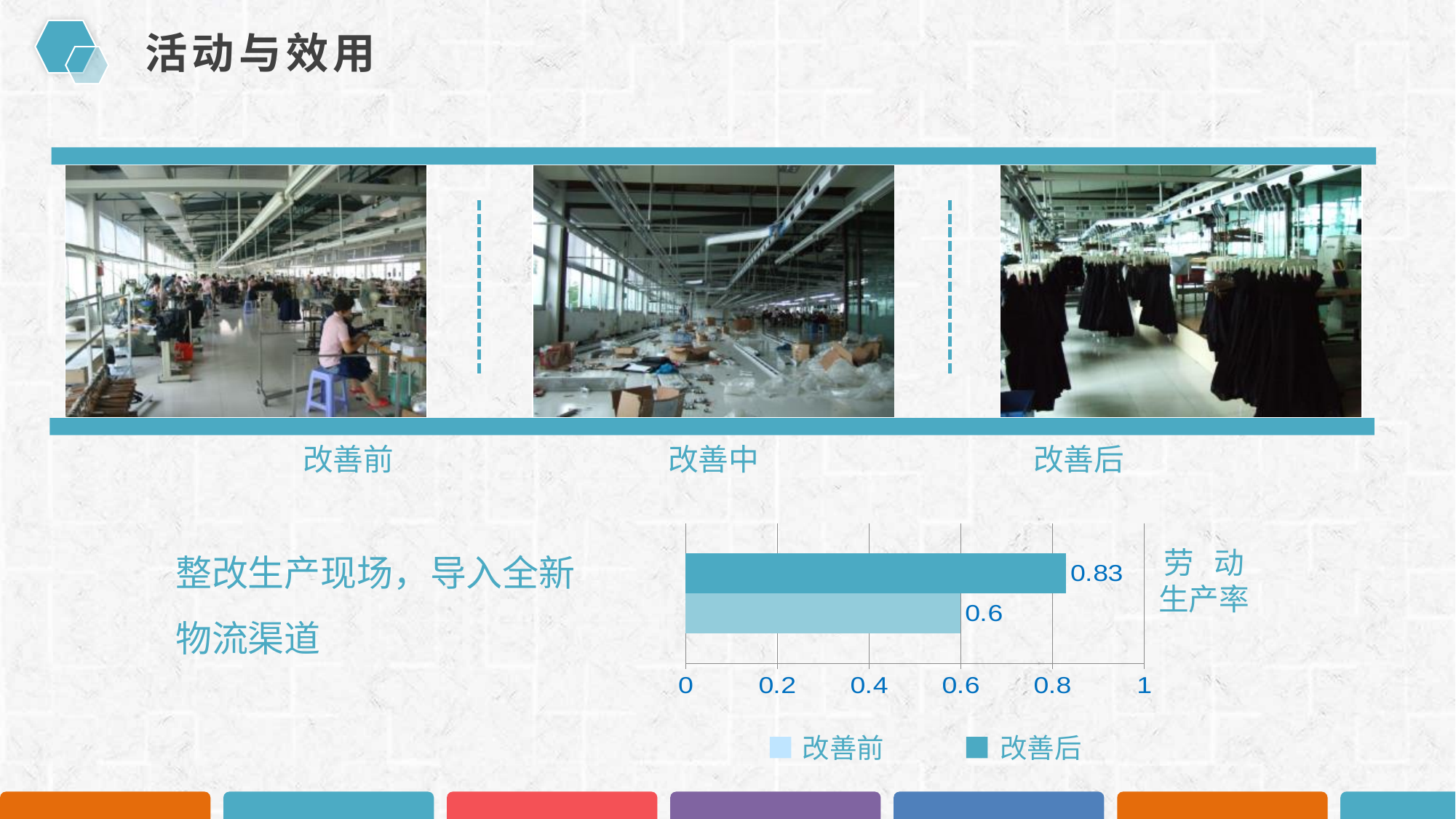
What is the value for 改善前 in the 劳动生产率 chart? 0.6 Which series has the highest value in the 劳动生产率 chart? 改善后 Which series has the higher value in the 劳动生产率 chart, 改善前 or 改善后? 改善后 Which series has the lowest value in the 劳动生产率 chart? 改善前 Is the value for 改善后 in the 劳动生产率 chart greater or less than 0.8? greater What kind of chart is the 劳动生产率 chart? bar chart Which legend entry in the 劳动生产率 chart is shown in the darker blue colour? 改善后 What is the value for 改善后 in the 劳动生产率 chart? 0.83 Is the value for 改善前 in the 劳动生产率 chart greater or less than 0.8? less What is the maximum value shown on the x axis of the 劳动生产率 chart? 1 What is the difference between the 改善后 and 改善前 values in the 劳动生产率 chart? 0.23 How many series does the legend of the 劳动生产率 chart list? 2